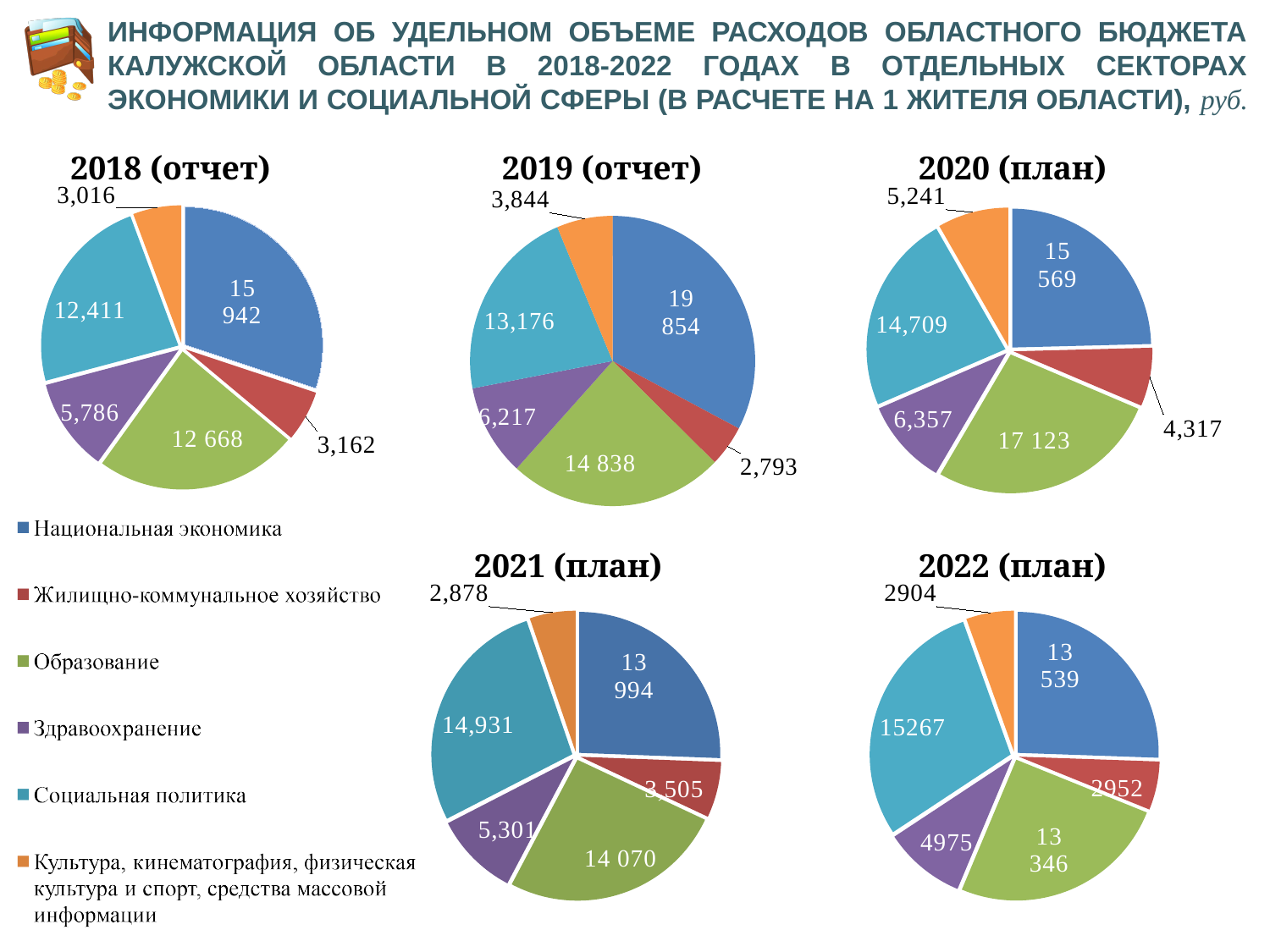
On the 2019 (отчет) pie chart, which category has the smallest value? Жилищно-коммунальное хозяйство On the 2021 (план) pie chart, what is the value for Социальная политика? 14,931 What type of chart is used for 2021 (план)? Pie chart How many pie charts are shown on the slide? 5 On the 2019 (отчет) pie chart, what is the value for Образование? 14 838 On the 2022 (план) pie chart, what is the value for Здравоохранение? 4975 On the 2020 (план) pie chart, what is the value for Жилищно-коммунальное хозяйство? 4,317 How many categories does the legend list? 6 On the 2019 (отчет) pie chart, what is the difference between Социальная политика and Здравоохранение? 6,959 On the 2018 (отчет) pie chart, which is larger: Образование or Социальная политика? Образование On the 2018 (отчет) pie chart, what is the value for Национальная экономика? 15 942 On the 2020 (план) pie chart, which category has the largest value? Образование